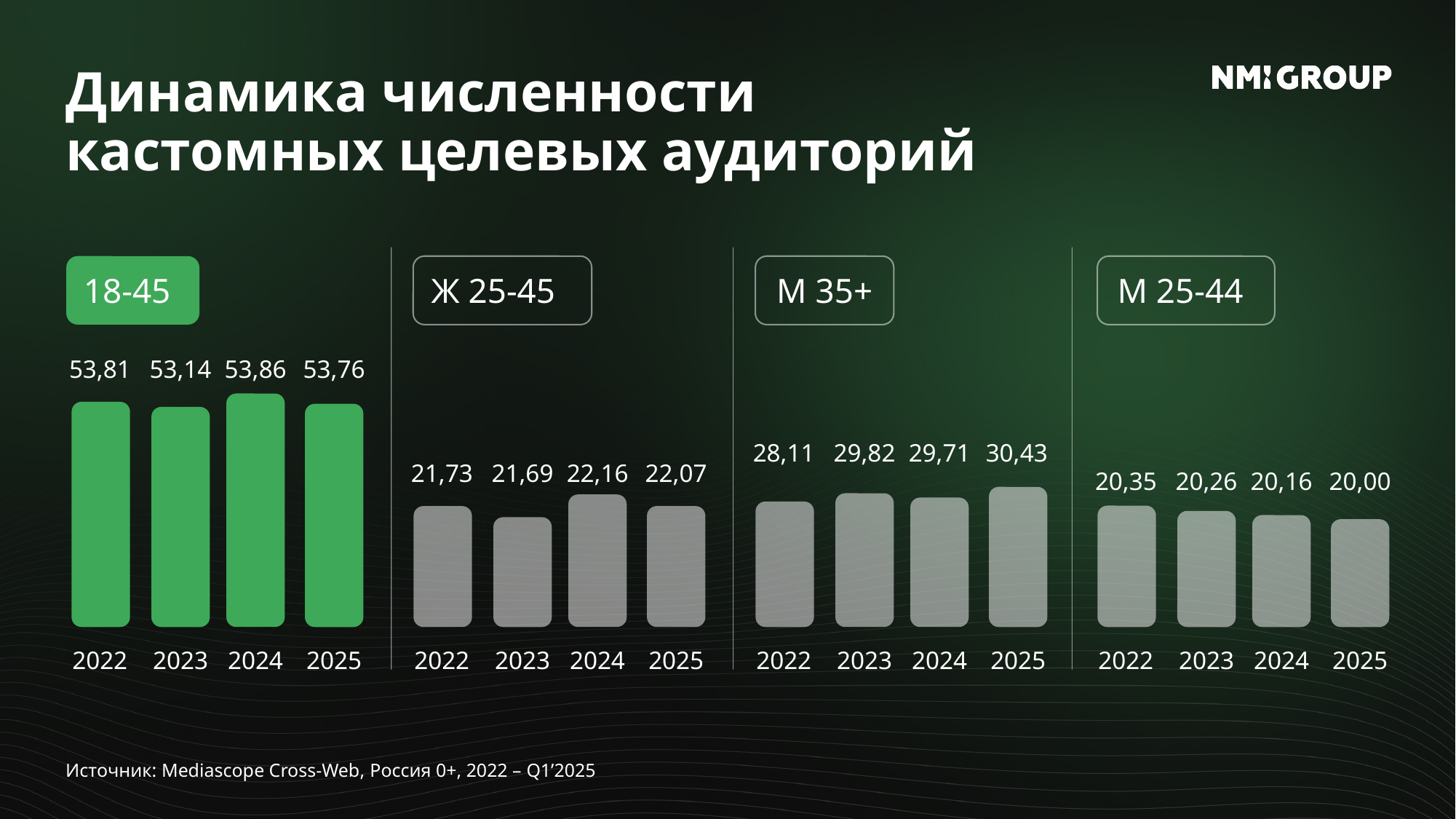
In the 18-45 chart, what is the value for 2022? 53,81 In the М 25-44 chart, which year has the lowest value? 2025 In the М 25-44 chart, what is the value for 2025? 20,00 In the М 25-44 chart, do the values rise or fall from 2022 to 2025? fall In the Ж 25-45 chart, what is the value for 2024? 22,16 In the 18-45 chart, which is larger, the value for 2023 or the value for 2025? 2025 What kind of chart is used for the 18-45 audience? bar chart In the М 35+ chart, which year has the highest value? 2025 In the М 35+ chart, what is the value for 2023? 29,82 In the М 35+ chart, what is the difference between the 2025 and 2022 values? 2,32 How many years are shown in the Ж 25-45 chart? 4 In the Ж 25-45 chart, what is the difference between the 2024 and 2023 values? 0,47